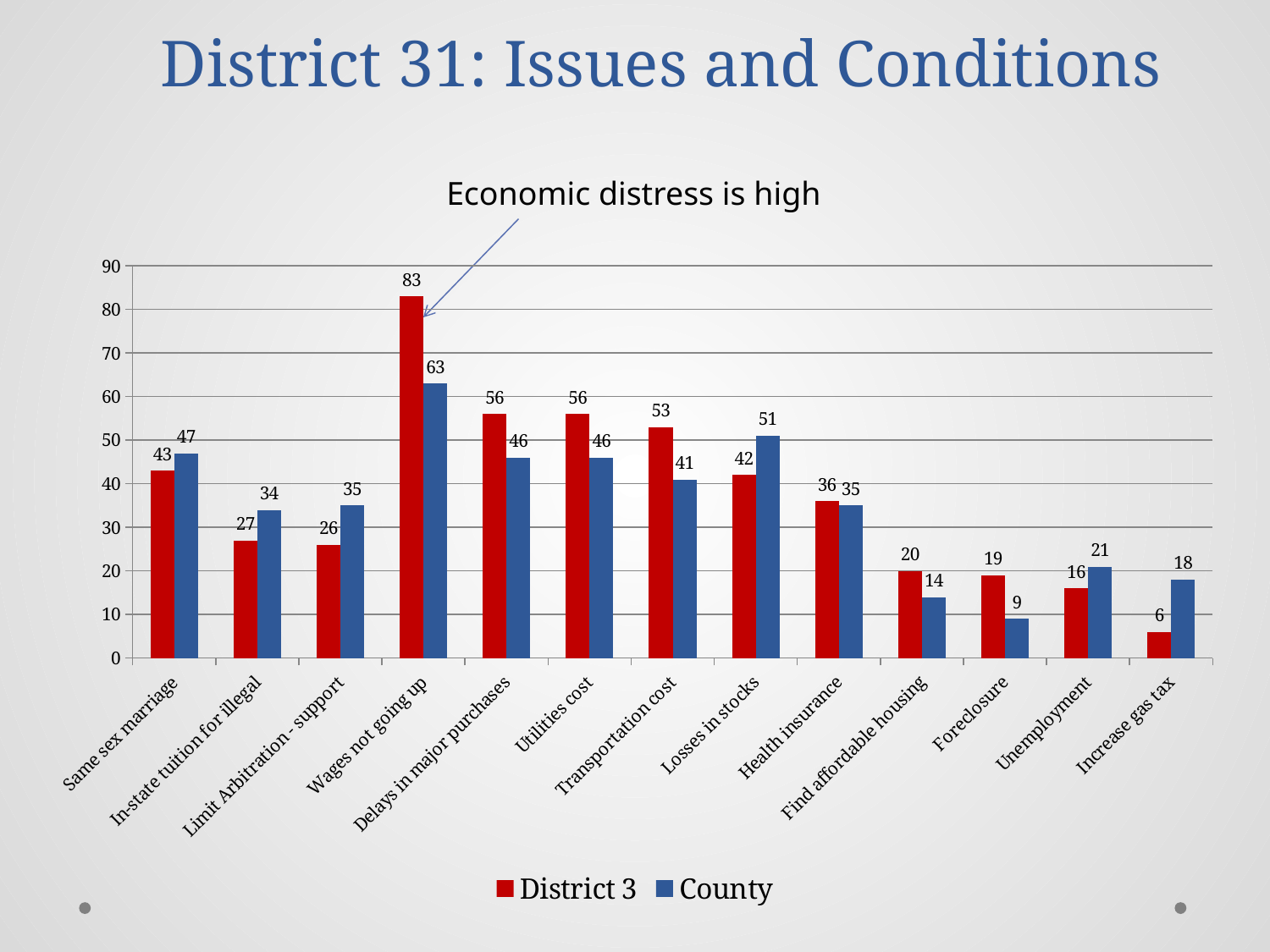
Which is larger for Increase gas tax, the District 3 value or the County value? County What is the difference between the District 3 and County values for Wages not going up? 20 How many series does the legend list? 2 What is the District 3 value for Wages not going up? 83 How many categories are shown on the x axis? 13 Is the County value for Delays in major purchases greater or less than 40? greater What is the County value for Foreclosure? 9 What kind of chart is shown on the slide? Bar chart What is the County value for Losses in stocks? 51 What is the title of the slide? District 31: Issues and Conditions Which category has the highest District 3 value? Wages not going up Which category has the lowest District 3 value? Increase gas tax